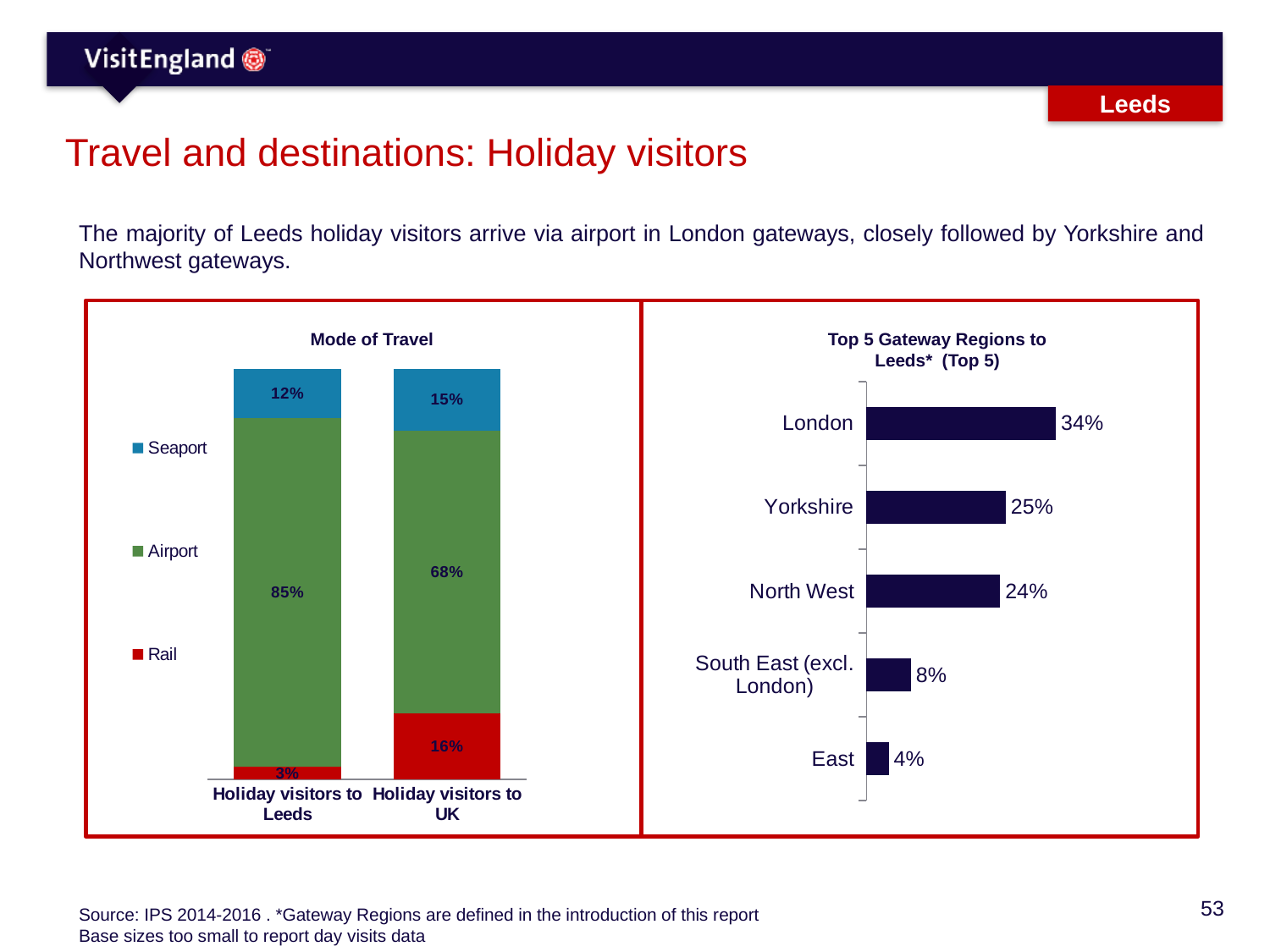
In the Mode of Travel chart, what percentage of holiday visitors to the UK arrive by rail? 16% In the Top 5 Gateway Regions to Leeds chart, which region has the highest value? London In the Mode of Travel chart, which is larger: the rail share for holiday visitors to Leeds or for holiday visitors to the UK? Holiday visitors to UK What kind of chart is the Top 5 Gateway Regions to Leeds chart? Bar chart In the Mode of Travel chart, what percentage of holiday visitors to Leeds arrive by airport? 85% In the Top 5 Gateway Regions to Leeds chart, what is the difference between London and Yorkshire? 9% In the Mode of Travel chart, what is the difference between the seaport share for holiday visitors to the UK and for holiday visitors to Leeds? 3% In the Top 5 Gateway Regions to Leeds chart, how many regions are shown? 5 In the Top 5 Gateway Regions to Leeds chart, which region has the lowest value? East In the Top 5 Gateway Regions to Leeds chart, what is the value for North West? 24% In the Mode of Travel chart, what is the total of the stacked bar for holiday visitors to Leeds? 100% In the Mode of Travel chart, how many series does the legend list? 3